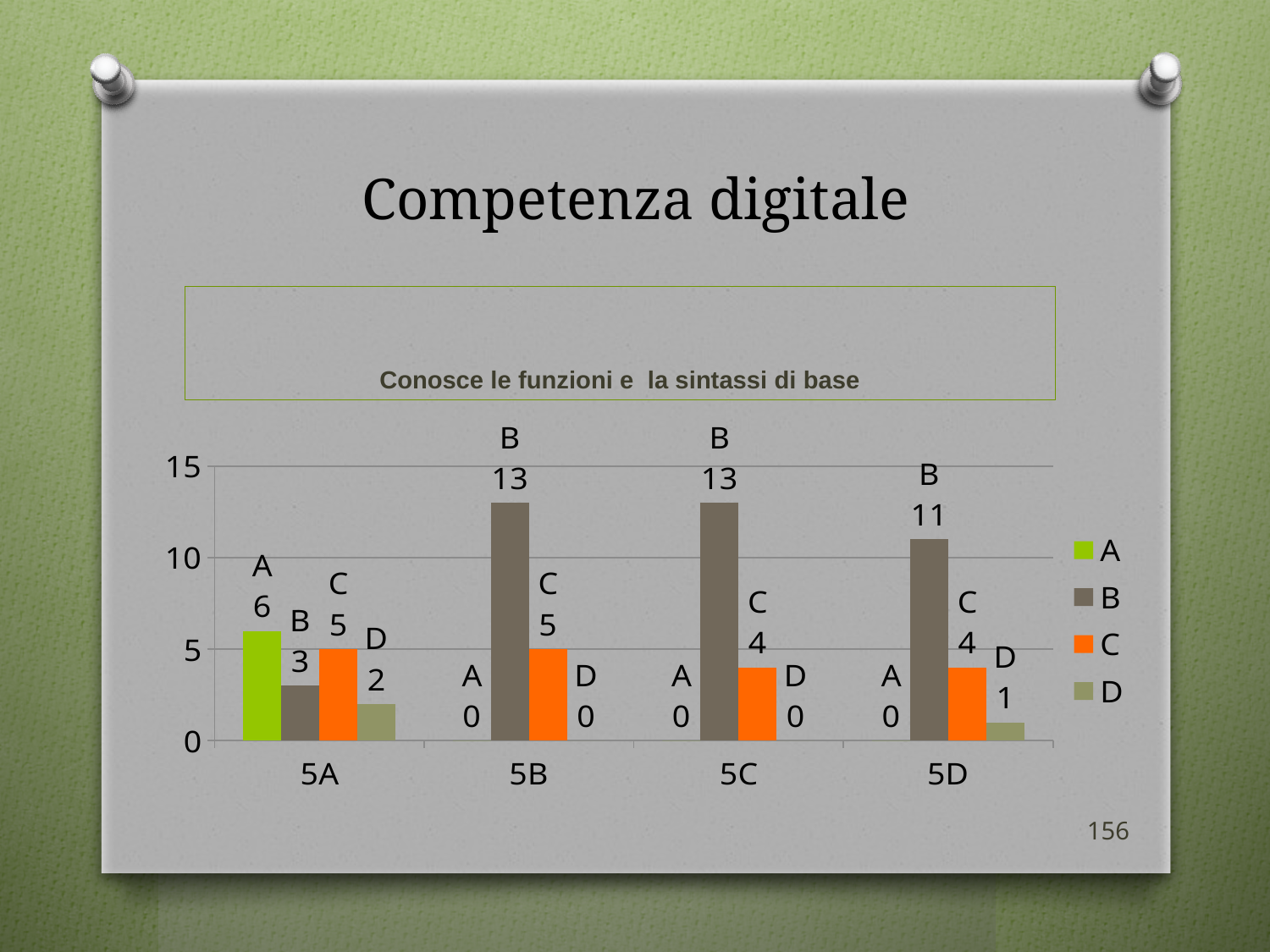
How many categories are shown on the x axis? 4 Which category has the lowest value for series B? 5A What kind of chart is shown on the slide? Bar chart What is the value of series B for category 5B? 13 Which category has the highest value for series B? 5B and 5C What is the value of series A for category 5A? 6 What is the value of series D for category 5D? 1 How many series does the legend list? 4 Which is larger: series C for 5A or series C for 5D? Series C for 5A What is the difference between the value of series B for 5B and the value of series B for 5D? 2 What is the title of the chart? Conosce le funzioni e la sintassi di base What is the value of series C for category 5C? 4